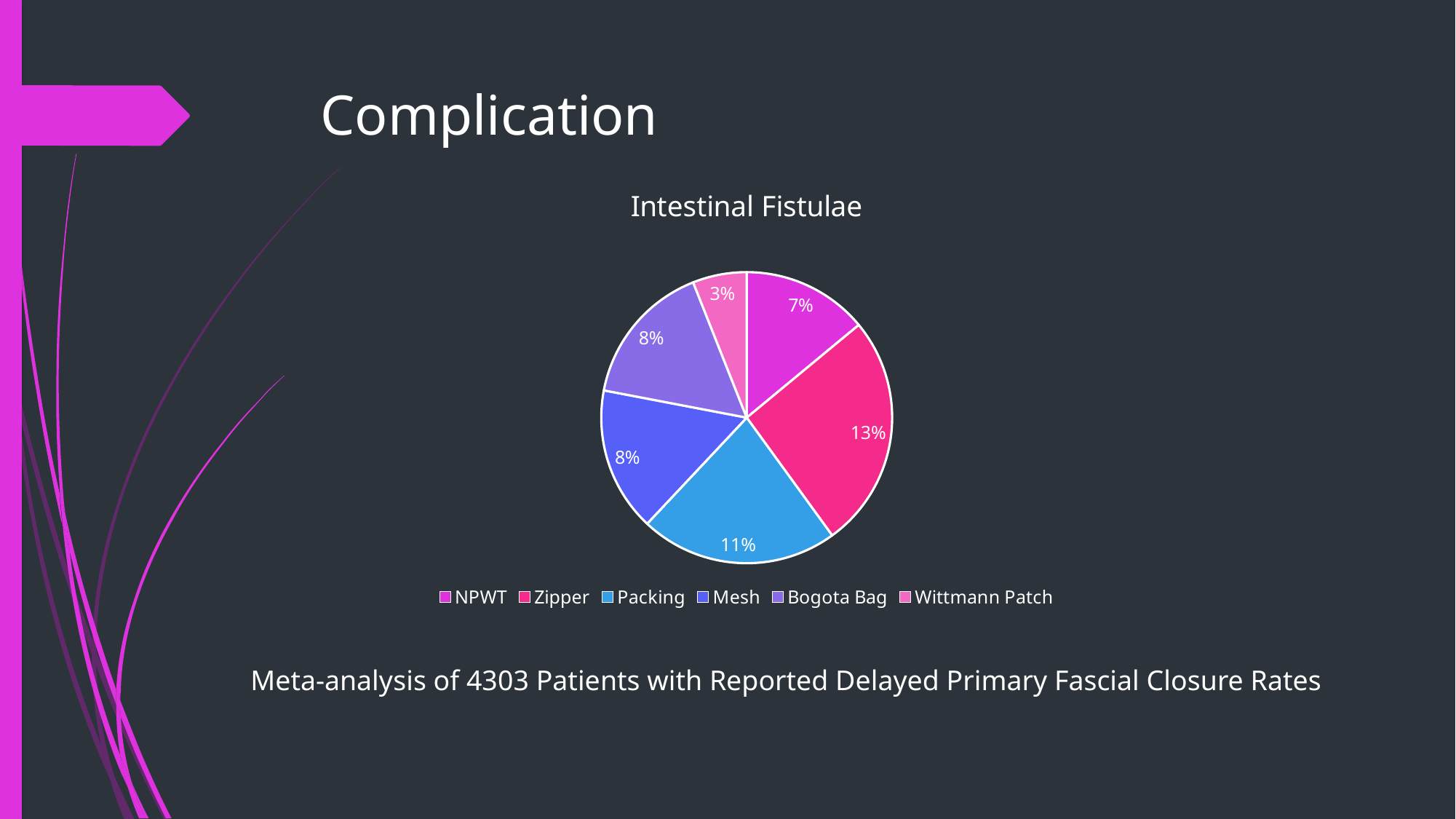
What value is shown for the NPWT slice? 7% Which category has the largest slice in the pie chart? Zipper Which is larger, the value for Packing or the value for NPWT? Packing Which category has the smallest slice in the pie chart? Wittmann Patch What value is shown for the Zipper slice in the Intestinal Fistulae pie chart? 13% What value is shown for the Packing slice? 11% What value is shown for the Wittmann Patch slice? 3% What kind of chart is shown on the slide? Pie chart What is the difference between the Zipper value and the Packing value? 2% What is the title of the chart? Intestinal Fistulae How many categories does the pie chart show? 6 What value is shown for the Mesh slice? 8%